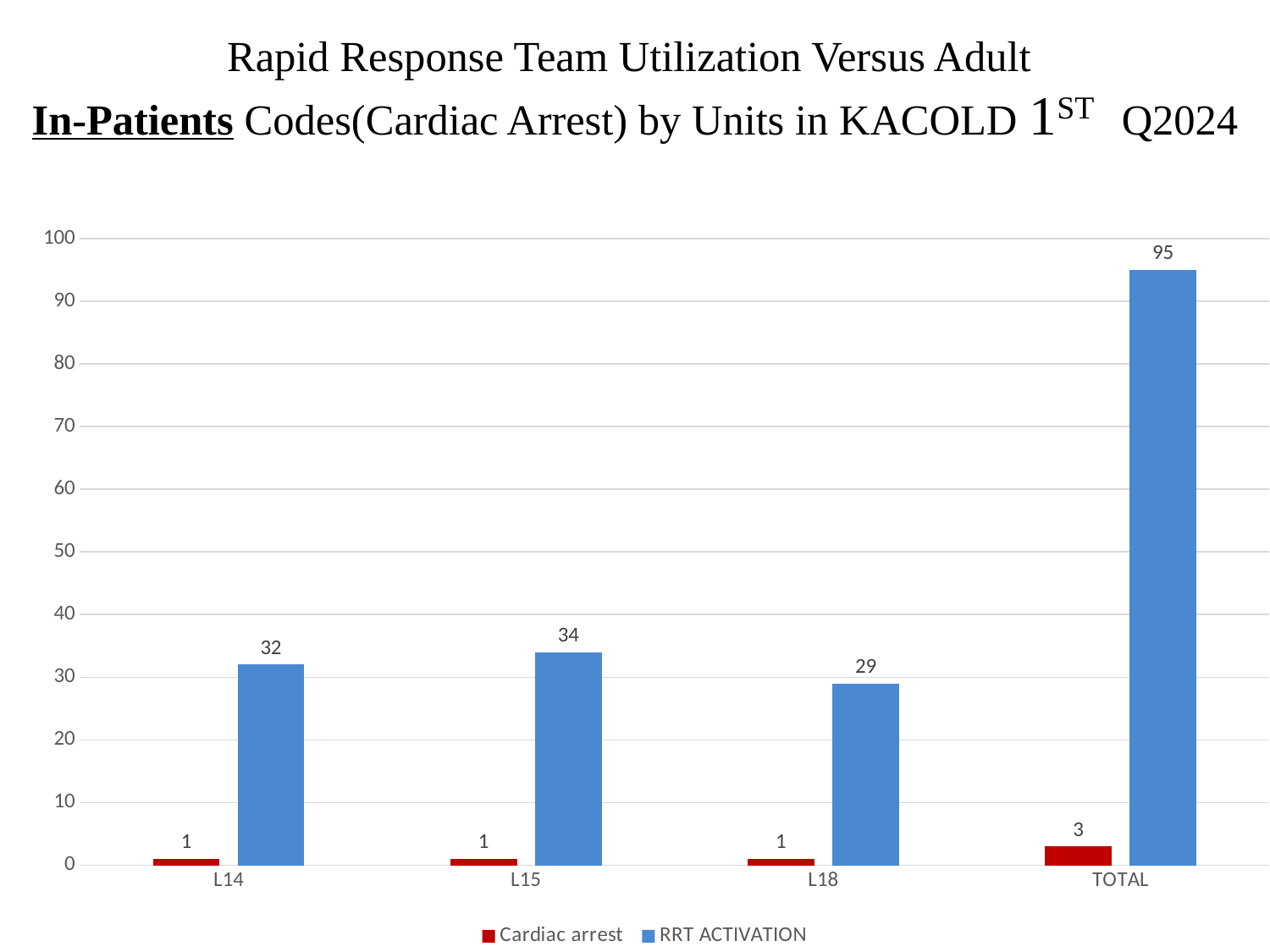
What is the Cardiac arrest value for TOTAL? 3 How many categories are shown on the x axis? 4 What colour are the Cardiac arrest bars? red What is the RRT ACTIVATION value for L18? 29 How many series does the legend list? 2 What kind of chart is shown on the slide? bar chart What is the RRT ACTIVATION value for L15? 34 Which is larger, the RRT ACTIVATION value for L14 or for L15? L15 What is the difference between the RRT ACTIVATION values for L15 and L18? 5 Is the RRT ACTIVATION value for TOTAL greater or less than 90? greater Which unit (excluding TOTAL) has the highest RRT ACTIVATION value? L15 Which unit (excluding TOTAL) has the lowest RRT ACTIVATION value? L18